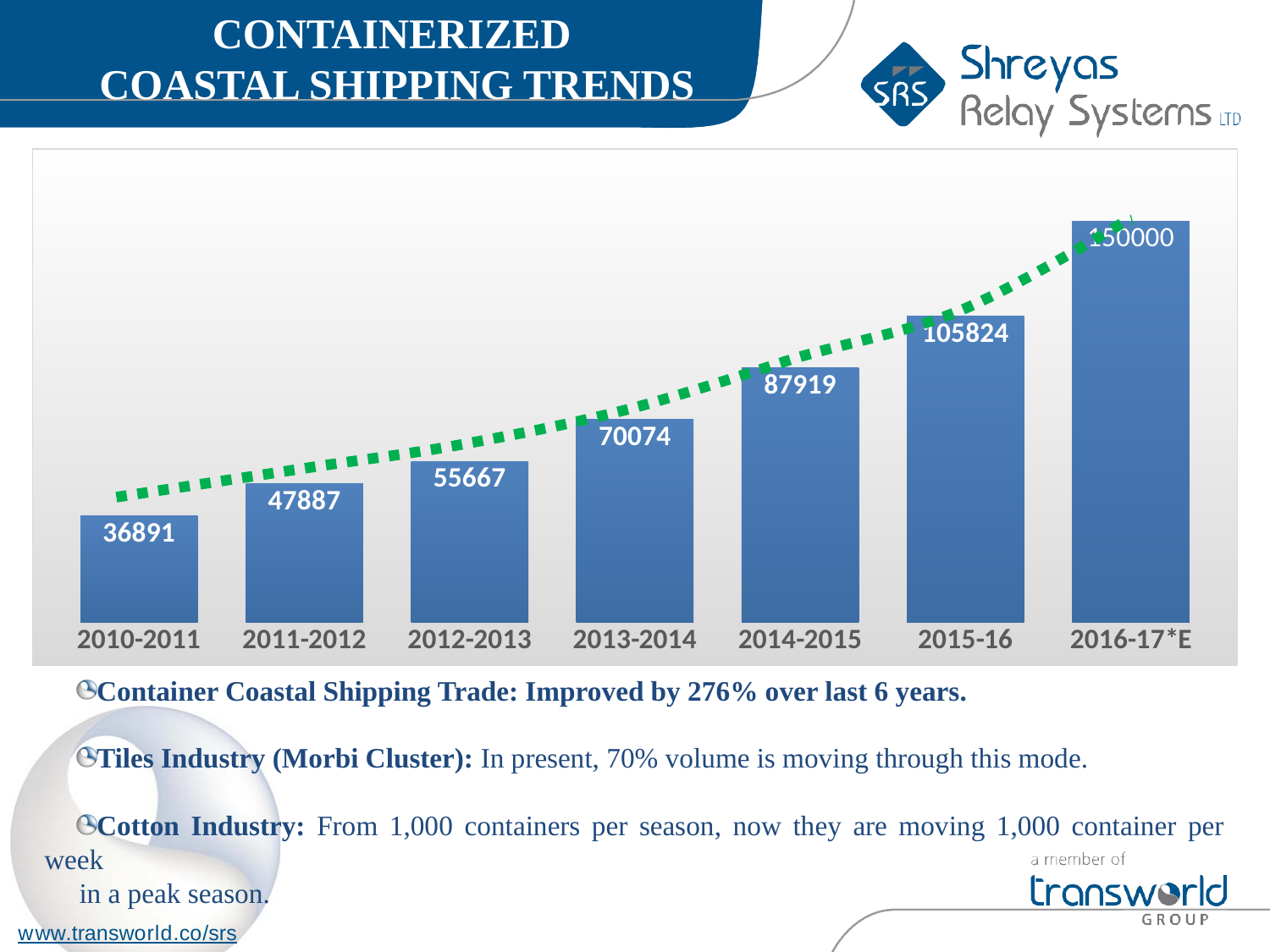
What is the value for 2013-2014? 70074 What kind of chart is this? bar chart Which period has the lowest value? 2010-2011 What is the difference between the values for 2016-17*E and 2015-16? 44176 What is the difference between the values for 2014-2015 and 2013-2014? 17845 What is the value for 2016-17*E? 150000 What is the value for 2015-16? 105824 Do the values rise or fall from 2010-2011 to 2016-17*E? rise How many periods are shown on the x axis? 7 Which is larger, the value for 2011-2012 or the value for 2012-2013? 2012-2013 What is the value for 2010-2011? 36891 Which period has the highest value? 2016-17*E